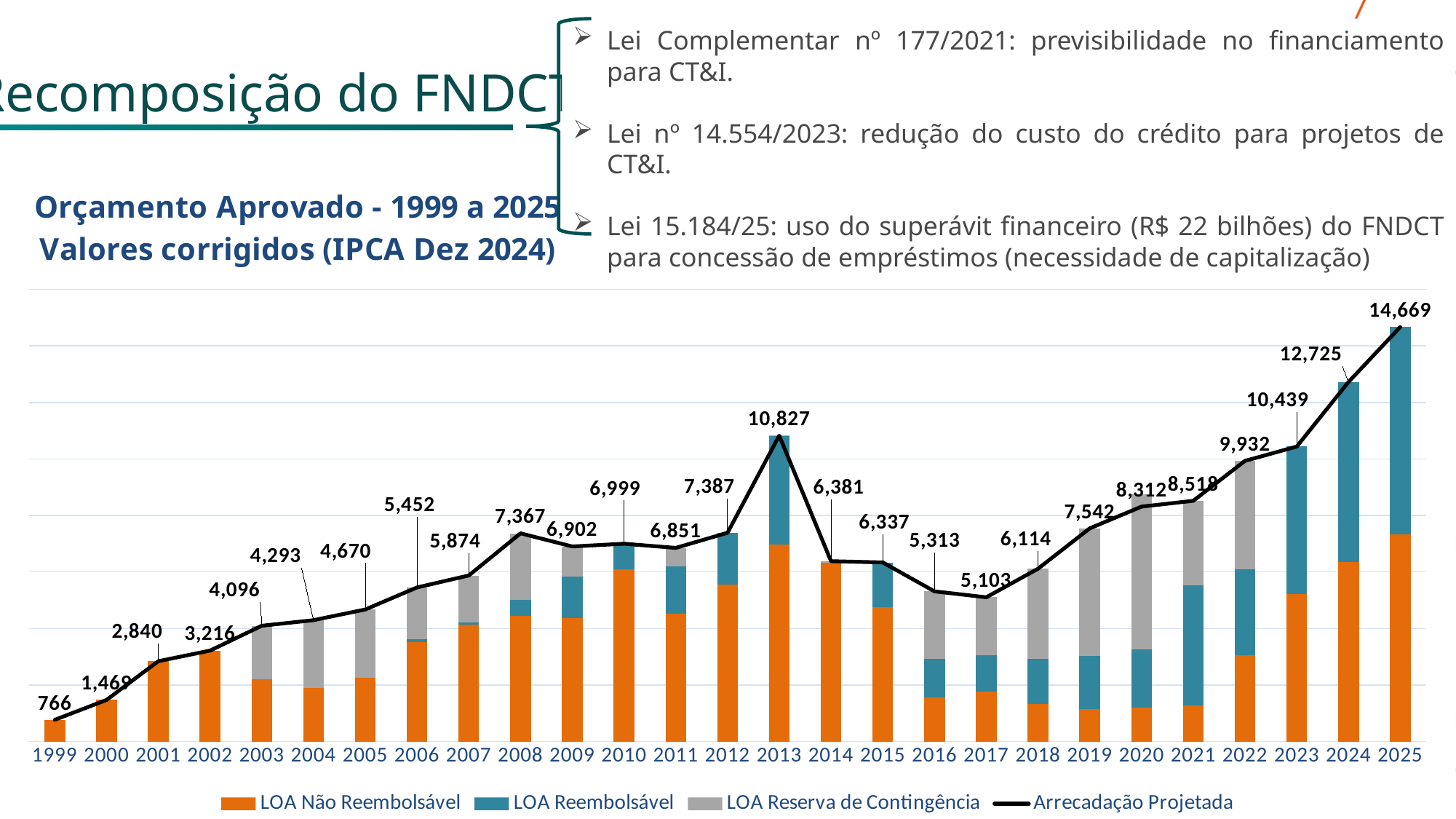
What is the Arrecadação Projetada value for 2025? 14,669 In which year is the Arrecadação Projetada lowest? 1999 In which year is the Arrecadação Projetada highest? 2025 What is the Arrecadação Projetada value for 2017? 5,103 Which series is shown in orange in the chart legend? LOA Não Reembolsável What is the difference between the Arrecadação Projetada values for 2013 and 2014? 4,446 What kind of chart is shown on the slide? Stacked bar chart with a line Which year has a larger Arrecadação Projetada value, 2008 or 2009? 2008 What is the Arrecadação Projetada value for 1999? 766 How many years are shown on the x axis of the chart? 27 What is the Arrecadação Projetada value for 2013? 10,827 How many series does the chart legend list? 4